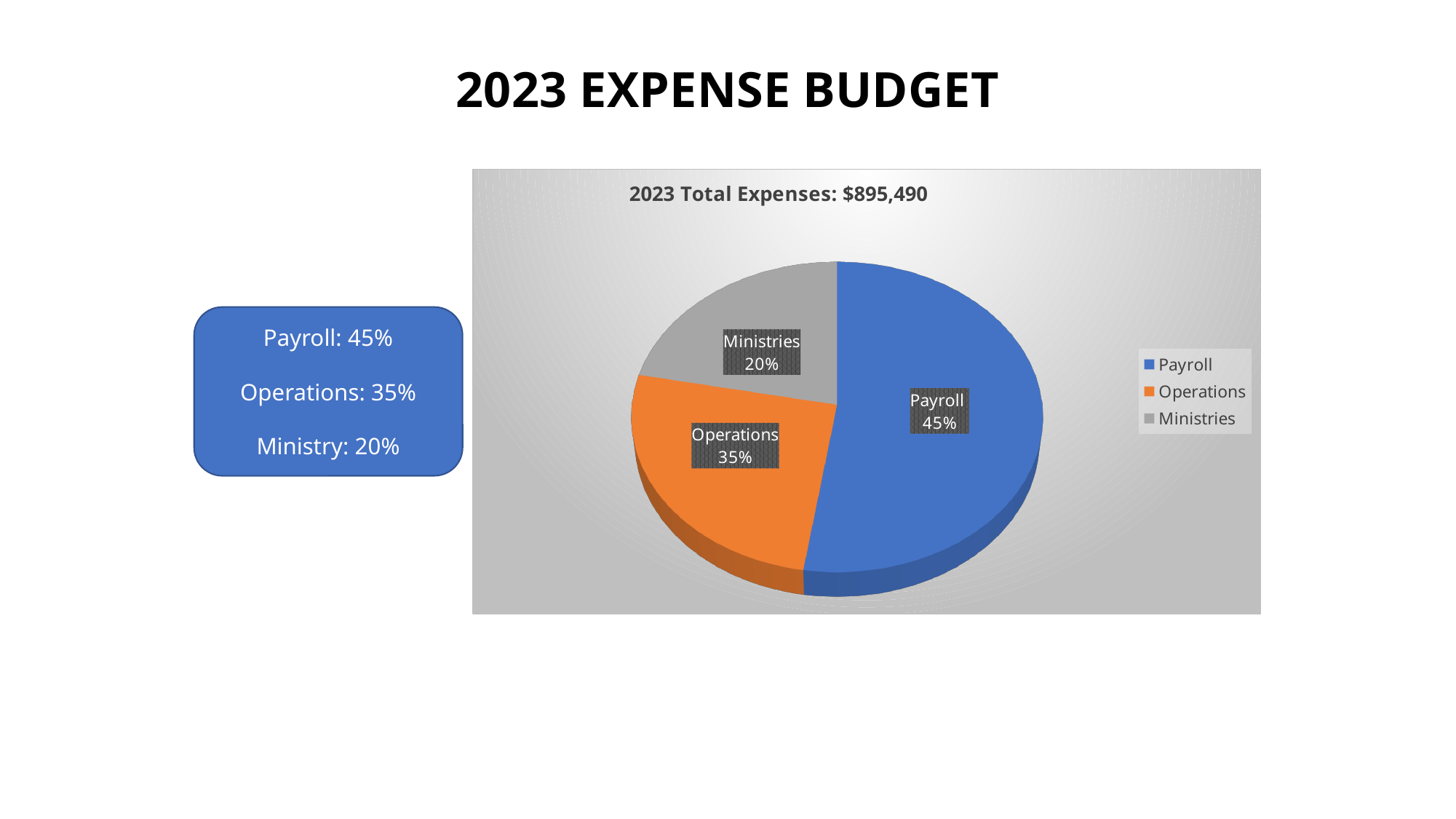
Which category has the smallest slice of the pie? Ministries What is the difference in percentage points between the Operations and Ministries slices? 15% Which slice is larger, Operations or Ministries? Operations What share of the pie does Ministries represent? 20% Which category has the largest slice of the pie? Payroll What share of the pie does Payroll represent? 45% What is the title of the chart? 2023 Total Expenses: $895,490 How many categories are shown in the pie chart? 3 What colour is the Operations slice in the pie chart? Orange What is the difference in percentage points between the Payroll and Operations slices? 10% What kind of chart is shown on the slide? Pie chart What share of the pie does Operations represent? 35%